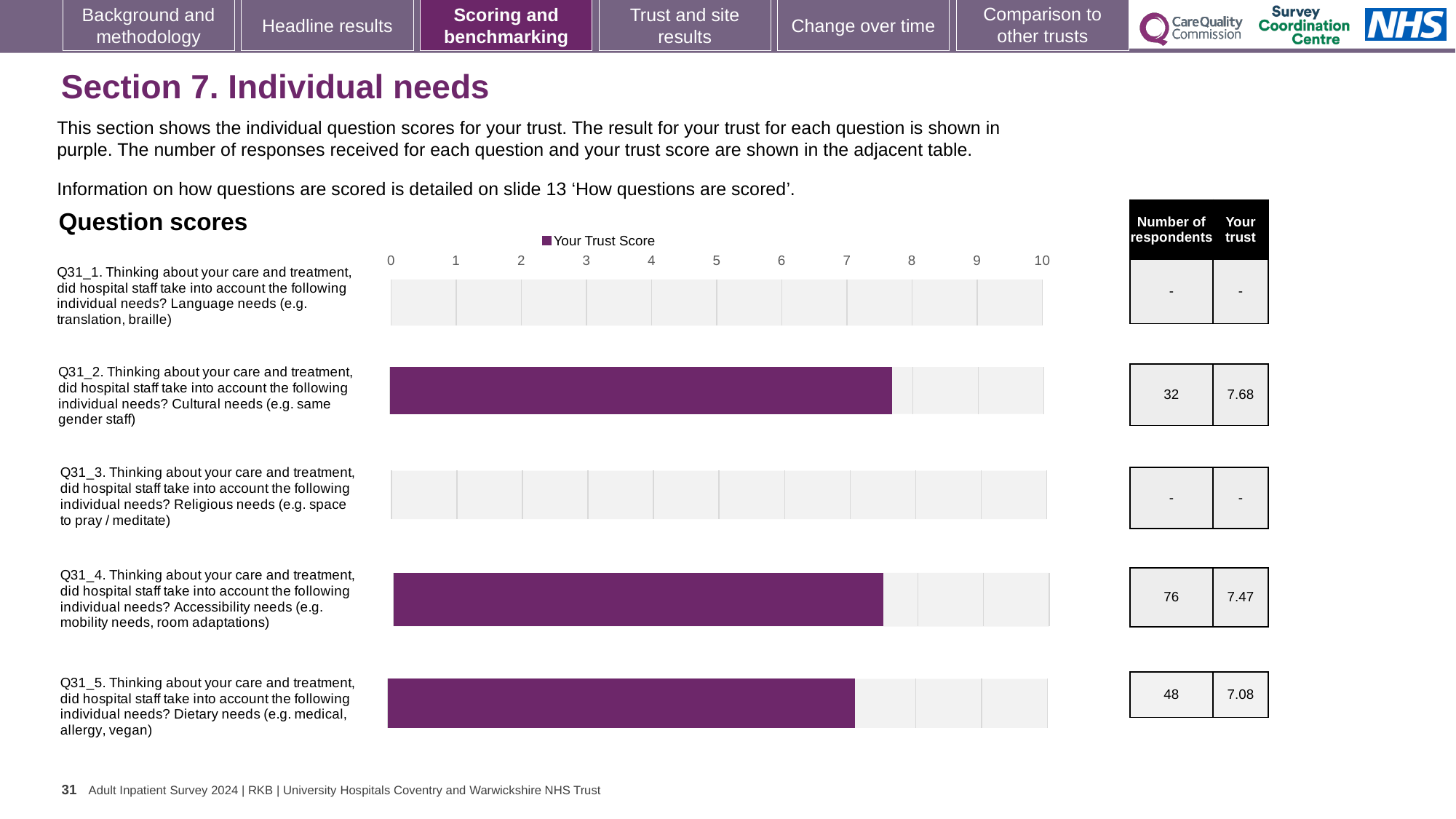
Which has a higher trust score, Q31_4 (accessibility needs) or Q31_5 (dietary needs)? Q31_4 (accessibility needs) How many respondents answered Q31_4 (accessibility needs)? 76 What is the difference between the trust scores for Q31_2 and Q31_5? 0.60 What is the trust score for Q31_5 (dietary needs)? 7.08 How many questions are listed on the chart? 5 What is the name of the series shown in the chart legend? Your Trust Score What type of chart is used to show the question scores? Bar chart What is the trust score for Q31_4 (accessibility needs)? 7.47 Among the questions with a plotted bar, which has the lowest trust score? Q31_5 (dietary needs) Which question has the highest trust score on the chart? Q31_2 (cultural needs) Is the trust score for Q31_2 (cultural needs) greater or less than 7? greater What is the trust score for Q31_2 (cultural needs)? 7.68